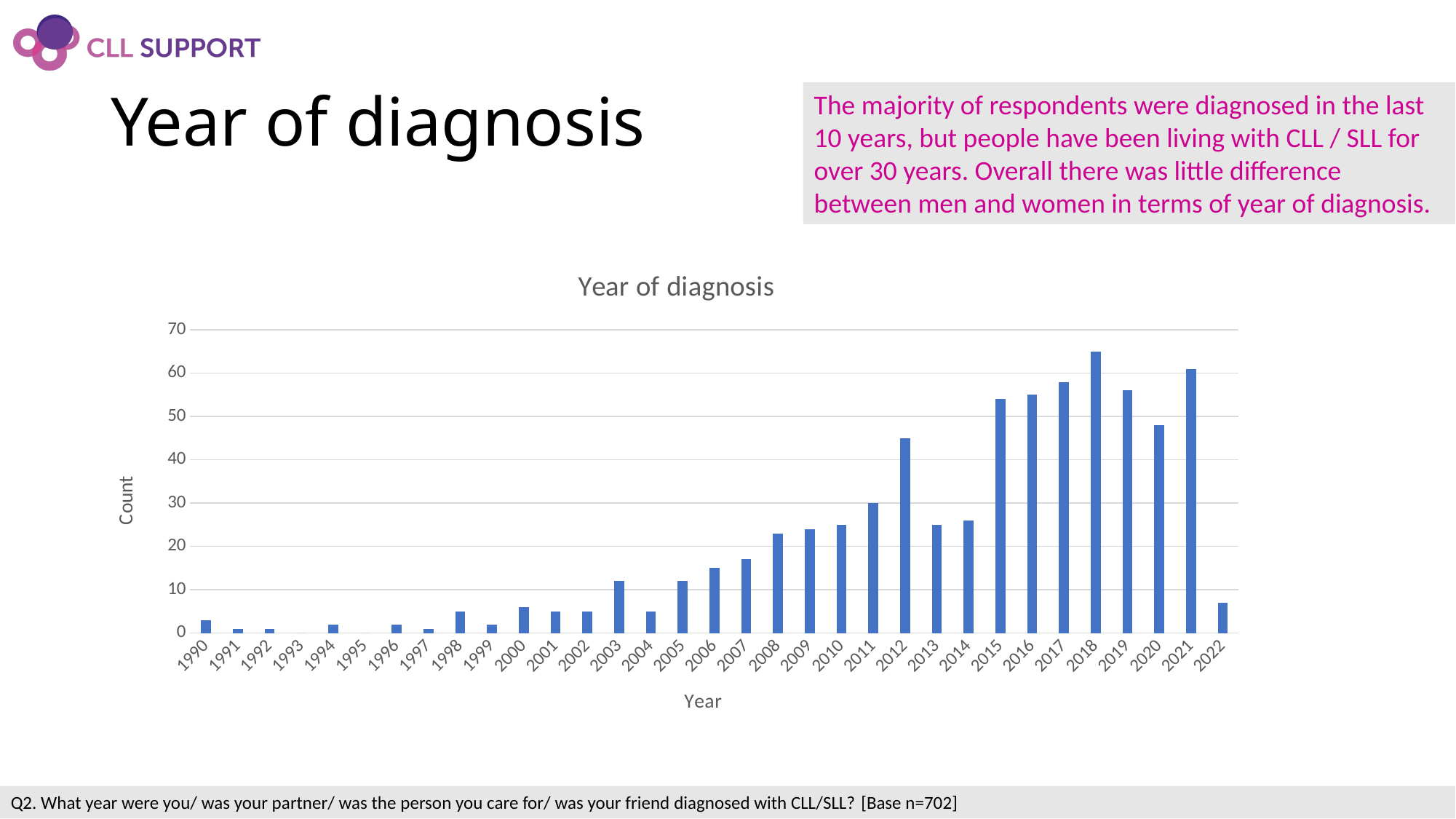
Is the value for 2012 greater or less than 40? greater Is the value for 2007 greater or less than 20? less Is the value for 2018 greater or less than 60? greater What is the title of the chart? Year of diagnosis What kind of chart is shown on the slide? bar chart Which year has the highest count in the chart? 2018 How many years are shown along the x axis of the chart? 33 Which year has the larger count, 2012 or 2013? 2012 What is the label on the vertical axis of the chart? Count Do the counts generally rise or fall from 1990 to 2018? rise